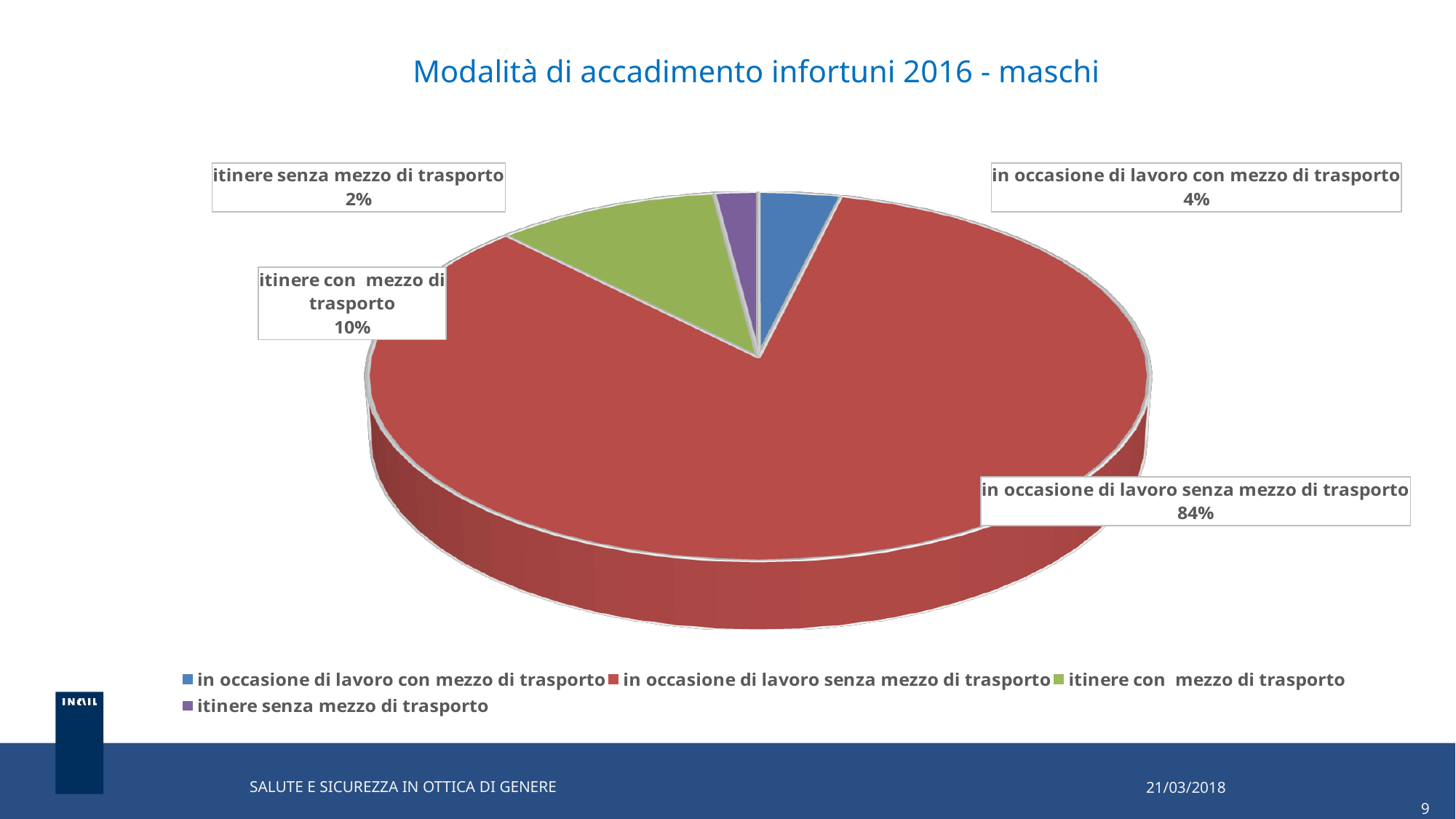
Which is larger: the share for 'itinere con mezzo di trasporto' or the share for 'itinere senza mezzo di trasporto'? itinere con mezzo di trasporto What share of the pie is 'itinere senza mezzo di trasporto'? 2% What is the title of the chart? Modalità di accadimento infortuni 2016 - maschi What share of the pie is 'itinere con mezzo di trasporto'? 10% What is the difference in percentage points between 'itinere con mezzo di trasporto' and 'in occasione di lavoro con mezzo di trasporto'? 6 percentage points What type of chart is shown on the slide? pie chart What colour is the slice for 'itinere con mezzo di trasporto'? green How many categories does the pie chart show? 4 What share of the pie is 'in occasione di lavoro senza mezzo di trasporto'? 84% Which category has the largest share of the pie? in occasione di lavoro senza mezzo di trasporto Which category has the smallest share of the pie? itinere senza mezzo di trasporto